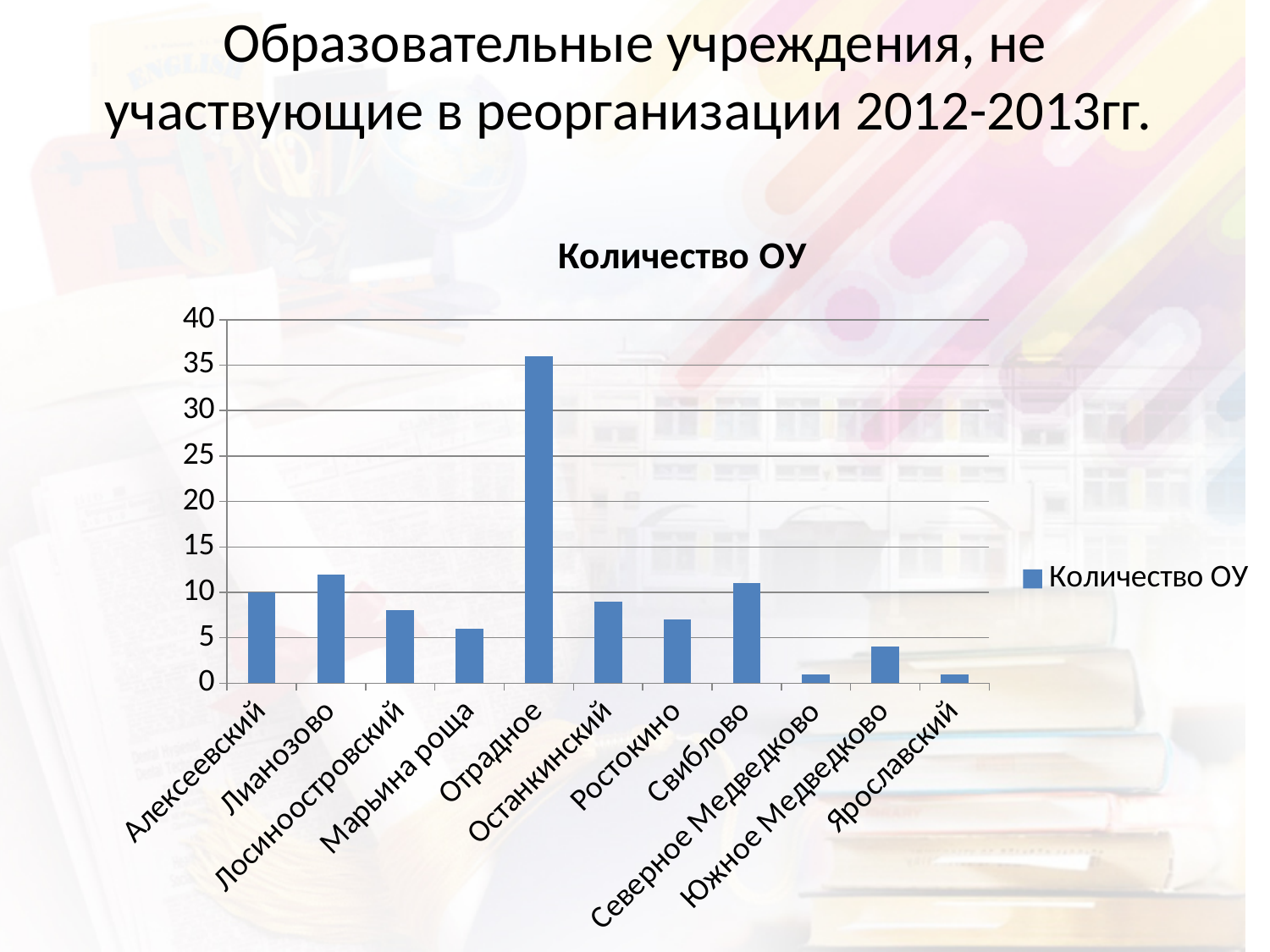
How many categories (districts) are shown on the x axis? 11 What type of chart is shown on the slide? bar chart Which is larger, the value for Лианозово or the value for Лосиноостровский? Лианозово Is the value for Лианозово greater or less than 10? greater Is the value for Ростокино greater or less than 10? less Is the value for Южное Медведково greater or less than 5? less What is the title of the chart? Количество ОУ Which district has the highest number of ОУ? Отрадное How many series does the legend list? 1 Which is larger, the value for Свиблово or the value for Марьина роща? Свиблово